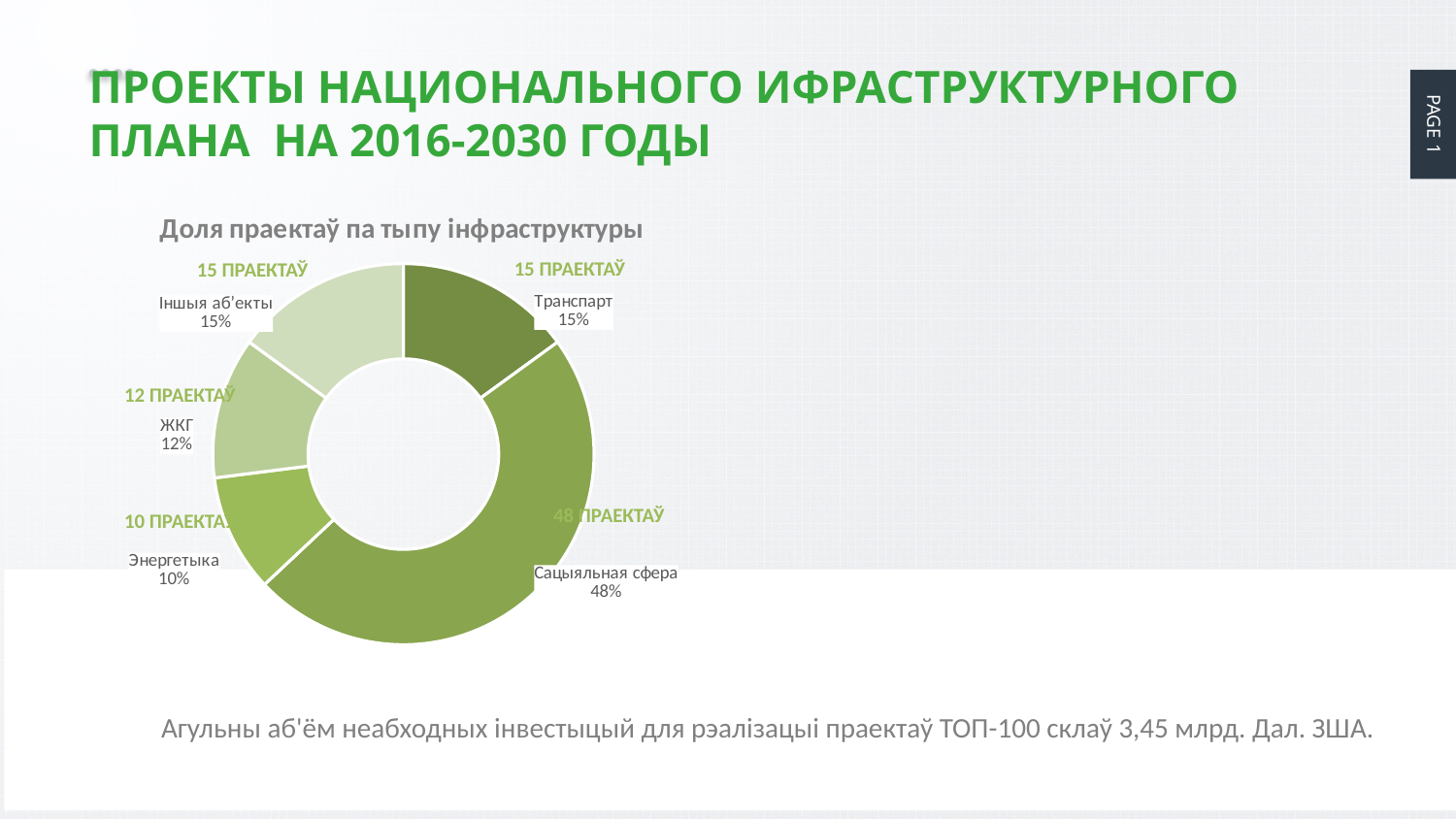
Which has a larger share, ЖКГ or Энергетыка? ЖКГ What share of projects does Энергетыка account for? 10% What share of projects does Сацыяльная сфера account for? 48% What is the title of the chart? Доля праектаў па тыпу інфраструктуры How many projects are in the Сацыяльная сфера category? 48 How many categories are shown in the chart? 5 Which category has the largest share of projects? Сацыяльная сфера Which category has the smallest share of projects? Энергетыка What type of chart is shown on the slide? Doughnut (pie) chart What share of projects does ЖКГ account for? 12% What is the difference in percentage points between Сацыяльная сфера and Транспарт? 33 percentage points